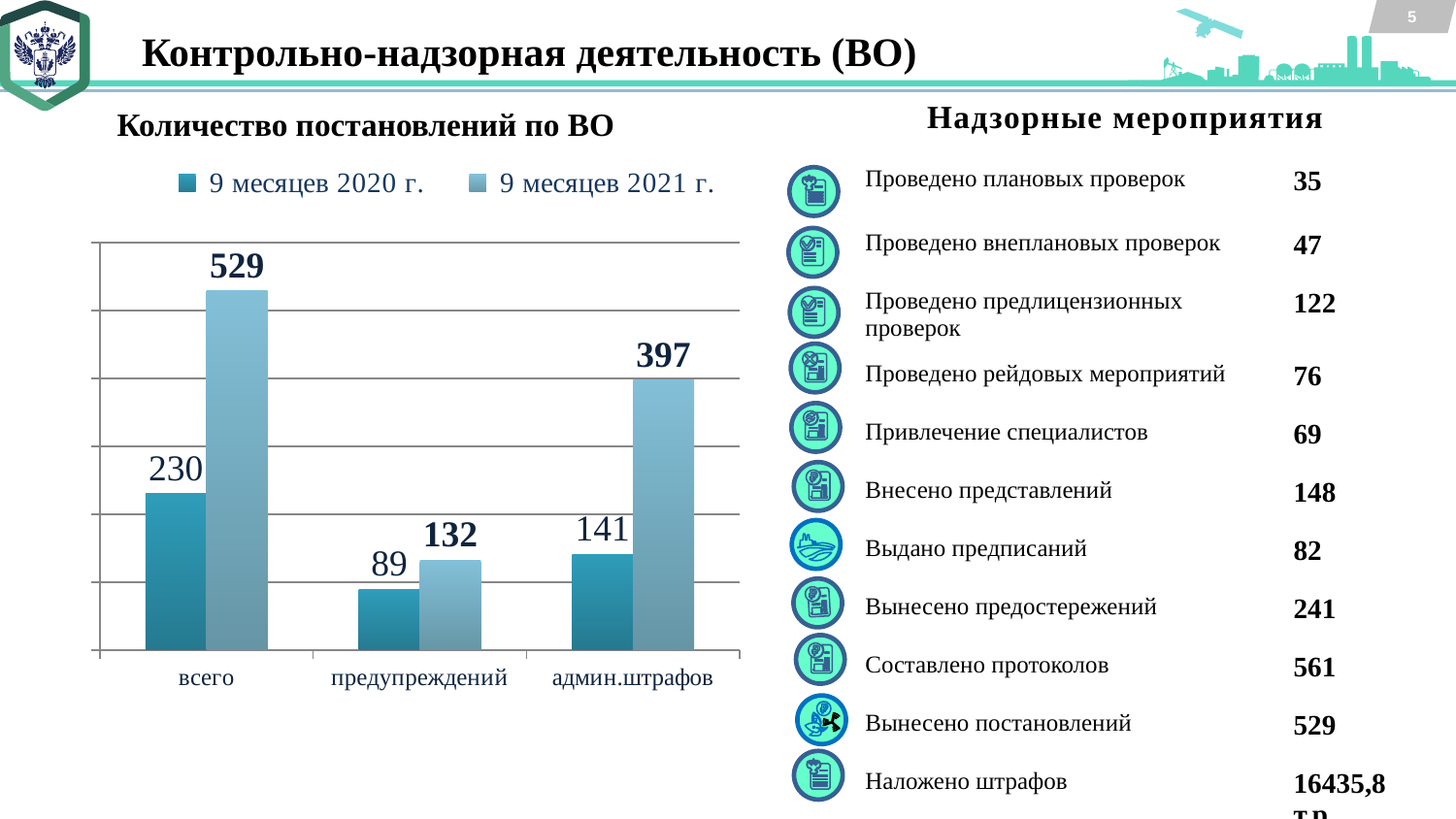
What kind of chart is shown on the slide? bar chart How many categories are shown on the x axis of the chart? 3 Which category has the lowest value in the "9 месяцев 2020 г." series? предупреждений What is the difference between the "9 месяцев 2021 г." and "9 месяцев 2020 г." values for "админ.штрафов"? 256 What is the value for "всего" in the "9 месяцев 2021 г." series? 529 What is the value for "предупреждений" in the "9 месяцев 2020 г." series? 89 Which category has the highest value in the "9 месяцев 2021 г." series? всего What is the value for "админ.штрафов" in the "9 месяцев 2020 г." series? 141 Which is larger: the "9 месяцев 2020 г." value for "всего" or the "9 месяцев 2021 г." value for "предупреждений"? 9 месяцев 2020 г. value for всего How many series does the chart legend list? 2 What is the value for "админ.штрафов" in the "9 месяцев 2021 г." series? 397 What is the difference between the "9 месяцев 2021 г." and "9 месяцев 2020 г." values for "всего"? 299